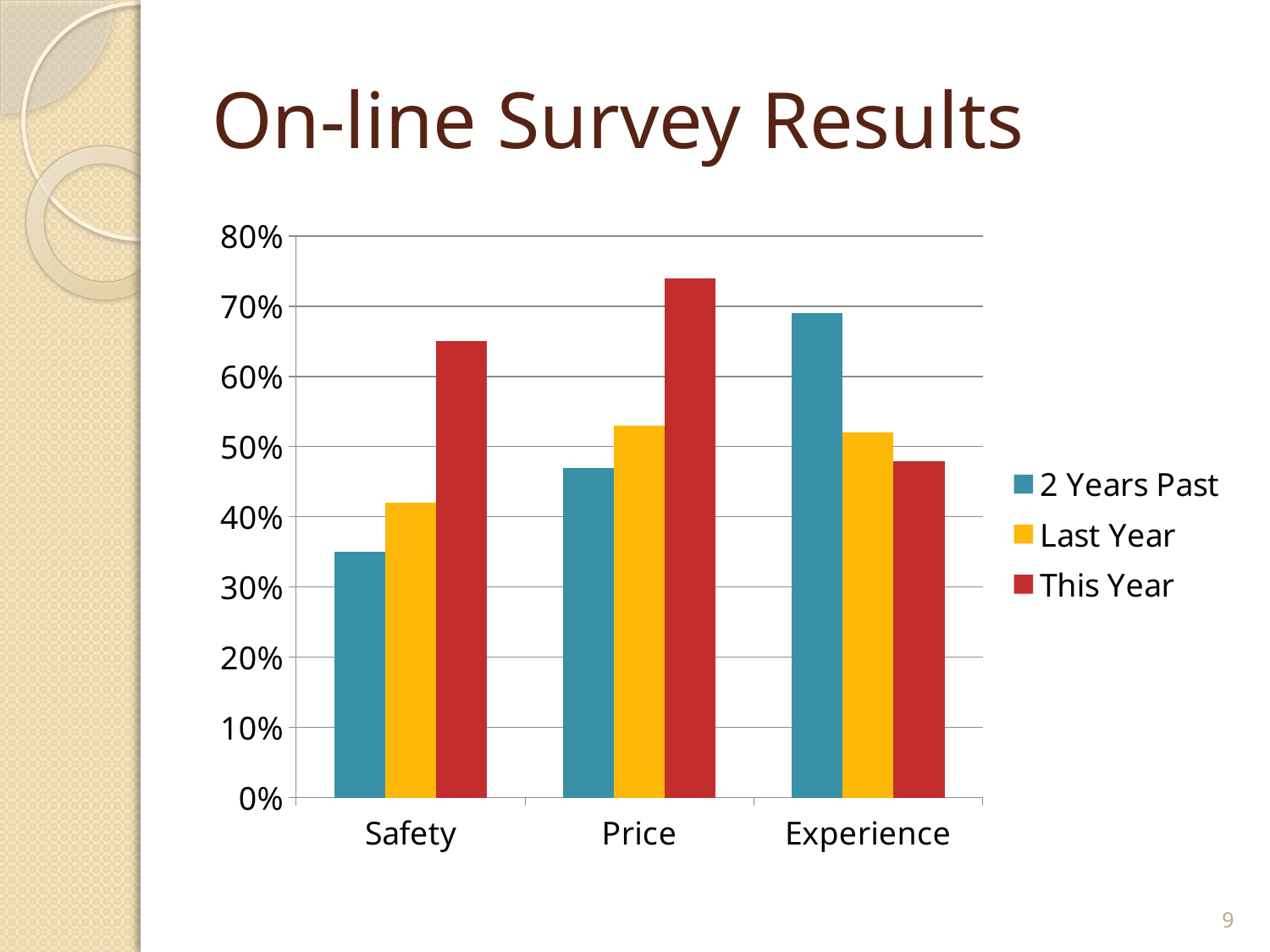
Is the 2 Years Past value for Safety greater or less than 40%? less Which category has the highest value for the 2 Years Past series? Experience Which is larger: the This Year value for Safety or the This Year value for Experience? Safety Is the This Year value for Price greater or less than 70%? greater Is the This Year value for Safety greater or less than 60%? greater Do the 2 Years Past values rise or fall from Safety to Experience? rise Which category has the highest value for the This Year series? Price What kind of chart is shown on the slide? bar chart How many categories are shown on the x axis? 3 Which category has the lowest value for the 2 Years Past series? Safety What is the title of the slide? On-line Survey Results How many series does the legend list? 3